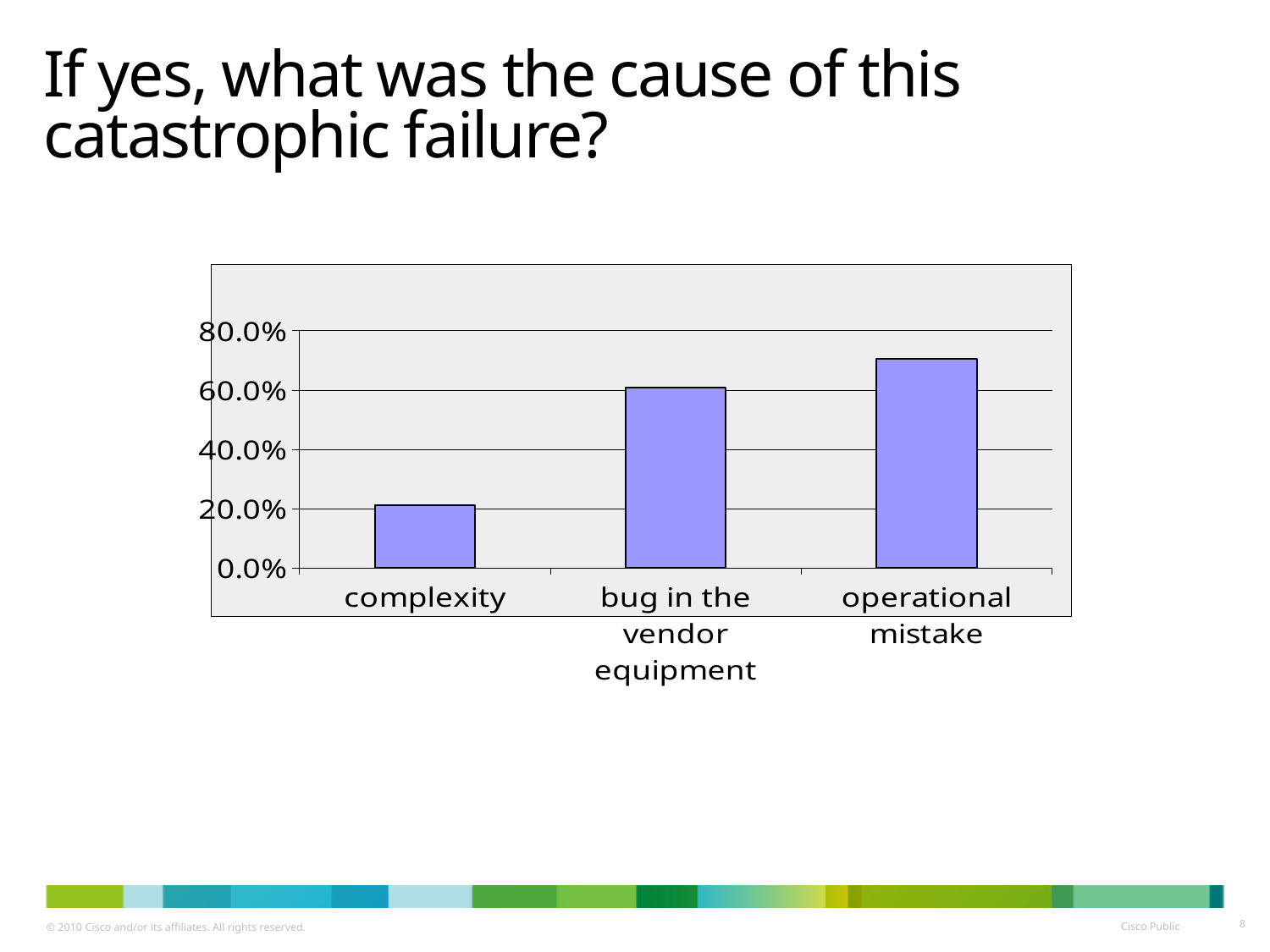
How many categories are shown on the x axis of the chart? 3 Is the value for operational mistake greater or less than 80.0%? less What is the highest value shown on the chart's y axis? 80.0% What kind of chart is shown on the slide? bar chart Is the value for operational mistake greater or less than 60.0%? greater Do the bar values rise or fall from left to right along the x axis? rise Is the value for complexity greater or less than 40.0%? less Which category has the lowest bar in the chart? complexity Which category has the highest bar in the chart? operational mistake Which is larger, the value for complexity or the value for bug in the vendor equipment? bug in the vendor equipment Which is larger, the value for bug in the vendor equipment or the value for operational mistake? operational mistake